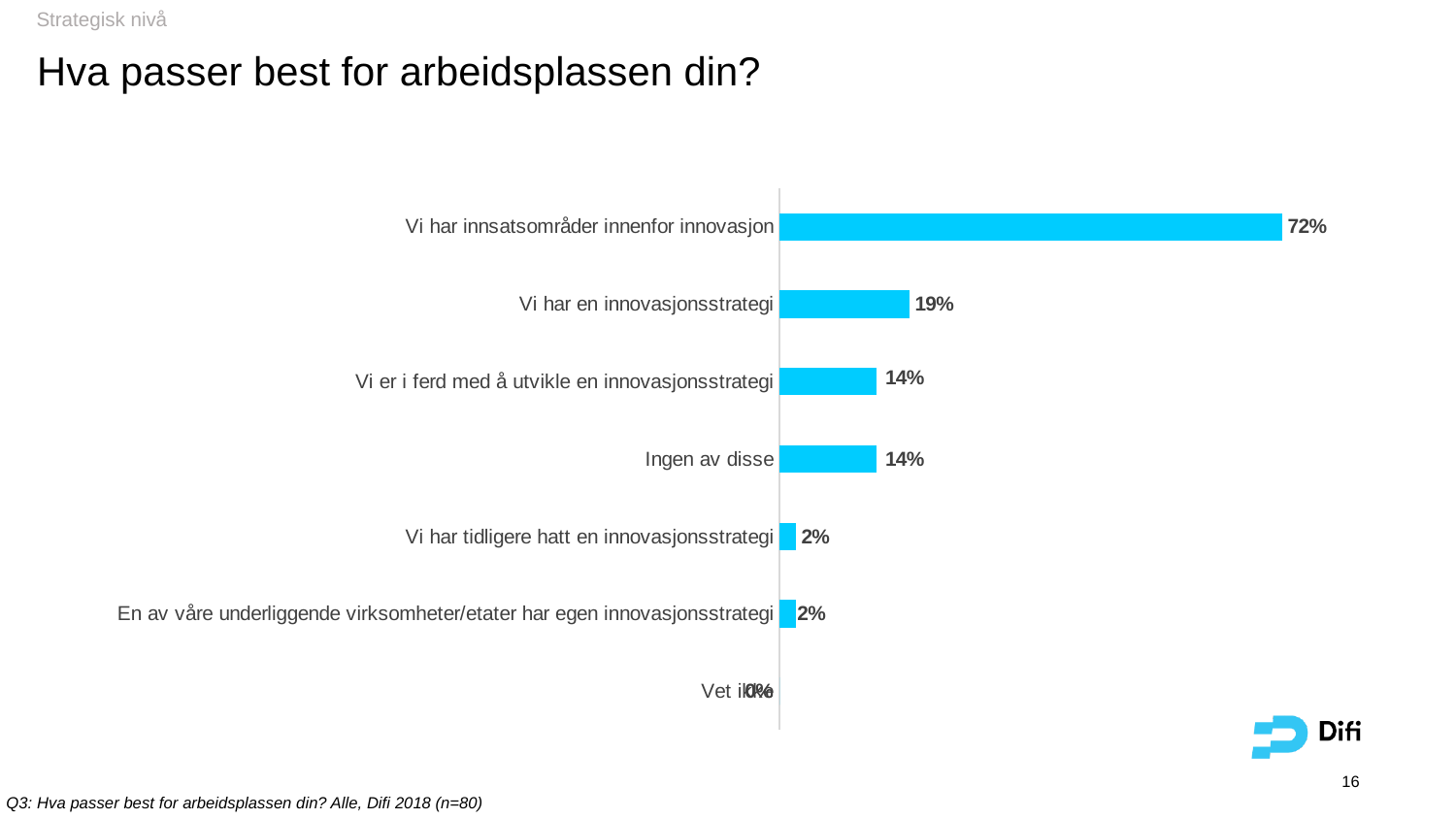
Which category has the highest value? Vi har innsatsområder innenfor innovasjon What is the value for "En av våre underliggende virksomheter/etater har egen innovasjonsstrategi"? 2% What is the difference between the values for "Vi har innsatsområder innenfor innovasjon" and "Vi har en innovasjonsstrategi"? 53% What is the value for "Ingen av disse"? 14% Which is larger, the value for "Vi har en innovasjonsstrategi" or the value for "Ingen av disse"? Vi har en innovasjonsstrategi What is the title of the slide containing the chart? Hva passer best for arbeidsplassen din? How many categories are shown in the chart? 7 What type of chart is shown on the slide? bar chart What is the value for "Vi har en innovasjonsstrategi"? 19% What is the value for "Vi er i ferd med å utvikle en innovasjonsstrategi"? 14% What is the value for "Vi har innsatsområder innenfor innovasjon"? 72% What is the value for "Vi har tidligere hatt en innovasjonsstrategi"? 2%